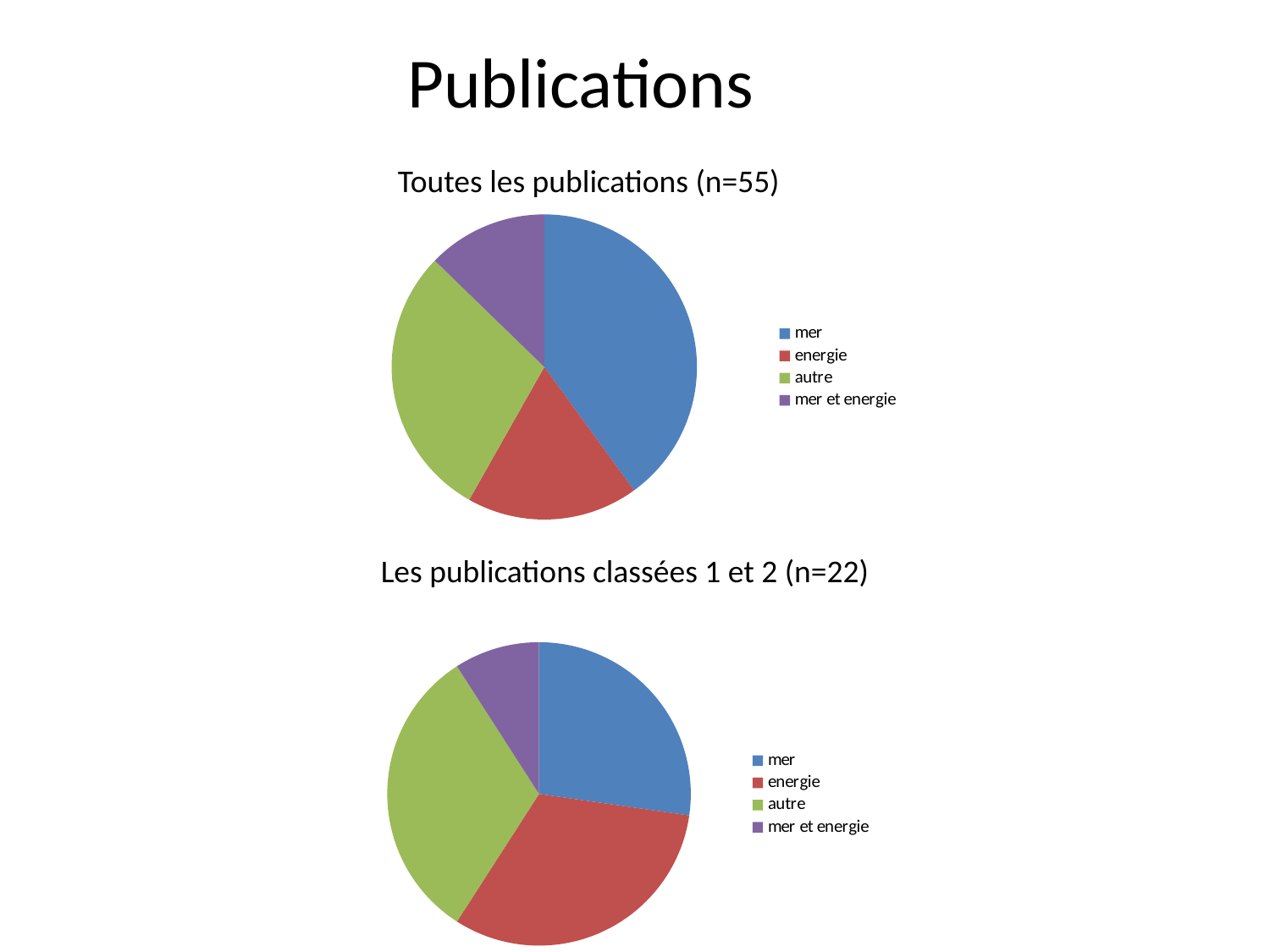
What kind of chart is the chart titled "Toutes les publications (n=55)"? pie chart What kind of chart is the chart titled "Les publications classées 1 et 2 (n=22)"? pie chart In the chart "Toutes les publications (n=55)", which category has the largest slice? mer In the chart "Les publications classées 1 et 2 (n=22)", which colour represents the category autre? green What is the title of the top chart on the slide? Toutes les publications (n=55) In the chart "Les publications classées 1 et 2 (n=22)", which category has the smallest slice? mer et energie In the chart "Les publications classées 1 et 2 (n=22)", which slice is larger, energie or mer et energie? energie In the chart "Les publications classées 1 et 2 (n=22)", how many slices does the pie have? 4 In the chart "Toutes les publications (n=55)", which category has the smallest slice? mer et energie In the chart "Toutes les publications (n=55)", how many categories does the legend list? 4 In the chart "Toutes les publications (n=55)", which slice is larger, mer or energie? mer In the chart "Toutes les publications (n=55)", which slice is larger, autre or energie? autre